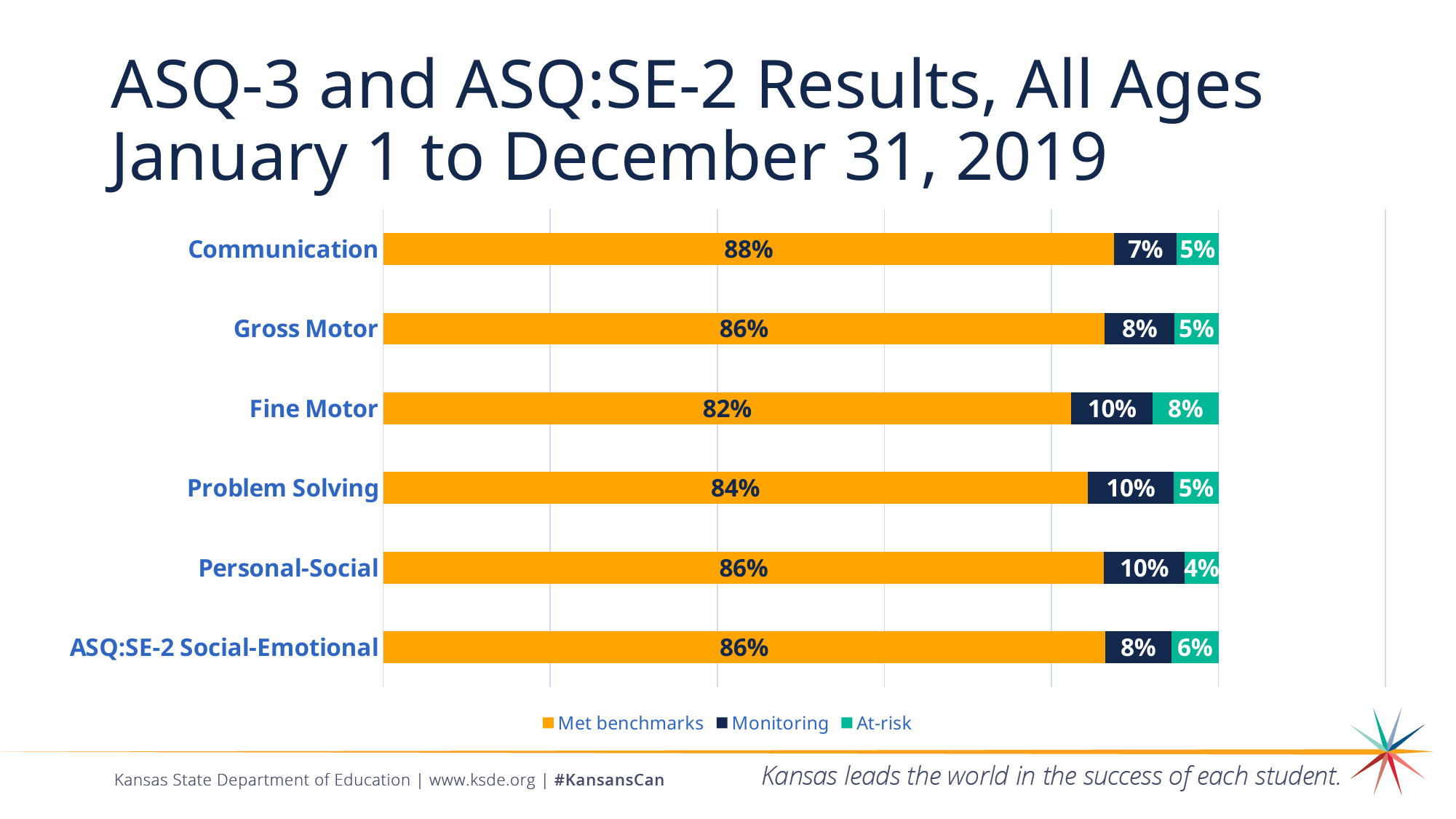
What is the At-risk value for ASQ:SE-2 Social-Emotional? 6% Which is larger, the Monitoring value for Communication or for Problem Solving? Problem Solving What kind of chart is shown on the slide? Stacked bar chart Which category has the lowest Met benchmarks percentage? Fine Motor Which series is shown in orange? Met benchmarks What is the difference between the Met benchmarks values for Communication and Fine Motor? 6% How many categories are shown on the chart? 6 What percentage of Communication results met benchmarks? 88% Which category has the highest At-risk percentage? Fine Motor Which category has the highest Met benchmarks percentage? Communication What is the Monitoring value for Fine Motor? 10% How many series does the legend list? 3